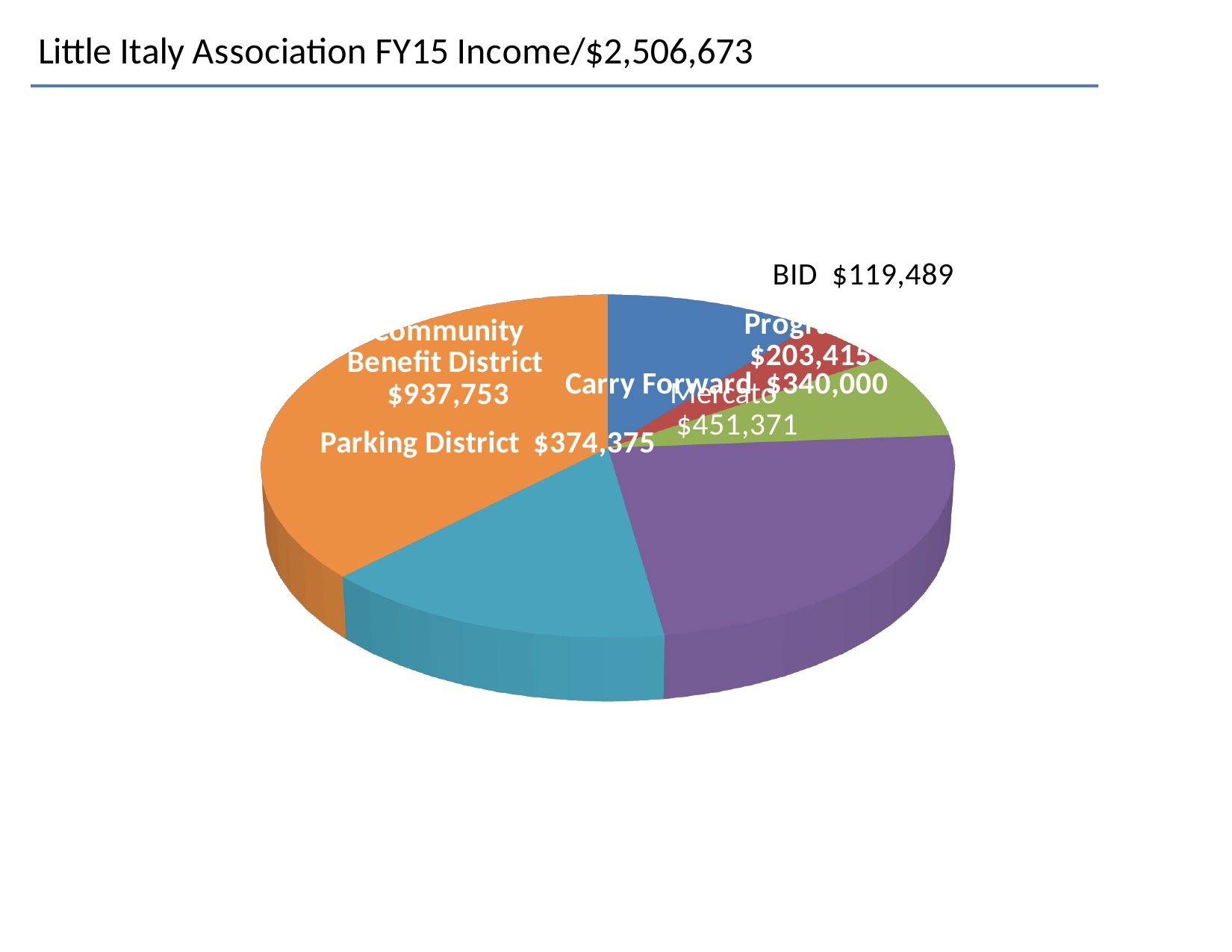
What is the value shown for Mercato? $451,371 What is the value shown for Community Benefit District? $937,753 What is the value shown for BID? $119,489 What is the difference between the Community Benefit District value and the Parking District value? $563,378 Which category has the largest value in the pie chart? Community Benefit District Which category has the smallest value in the pie chart? BID What total income figure is given in the slide title? $2,506,673 What is the value shown for Carry Forward? $340,000 Which is larger, Mercato or Carry Forward? Mercato What is the value shown for Parking District? $374,375 What kind of chart is shown on the slide? pie chart How many slices does the pie chart have? 6